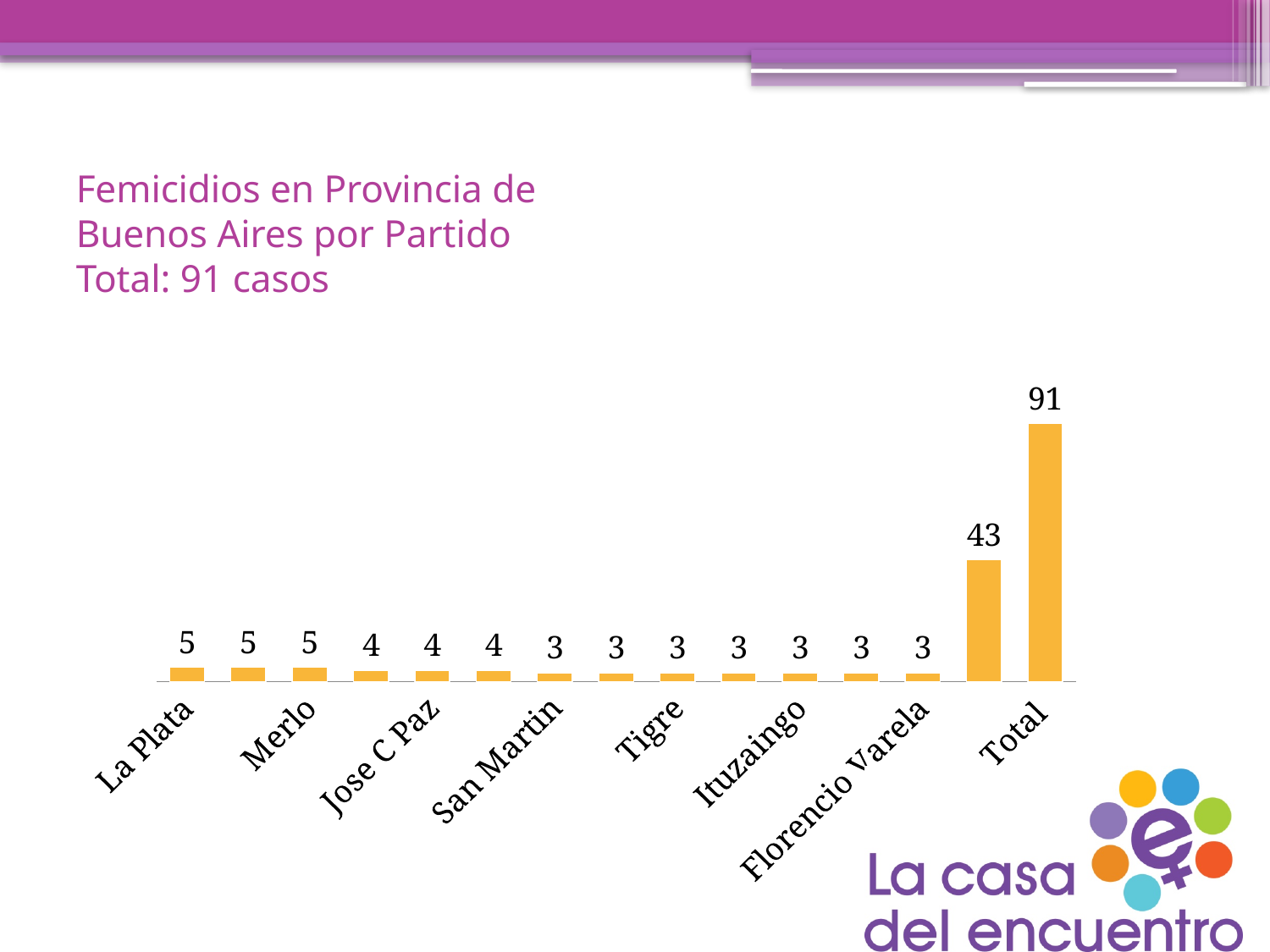
What is the value for Total? 91 How many bars are plotted in the chart? 15 What is the value of the bar immediately to the left of Total? 43 What is the value for La Plata? 5 What is the difference between the value for Total and the value for La Plata? 86 What is the value for Tigre? 3 Which is larger, the value for La Plata or the value for Jose C Paz? La Plata What kind of chart is shown on the slide? Bar chart What is the value for Merlo? 5 Which category has the highest value? Total What is the value for Jose C Paz? 4 What is the value for San Martin? 3